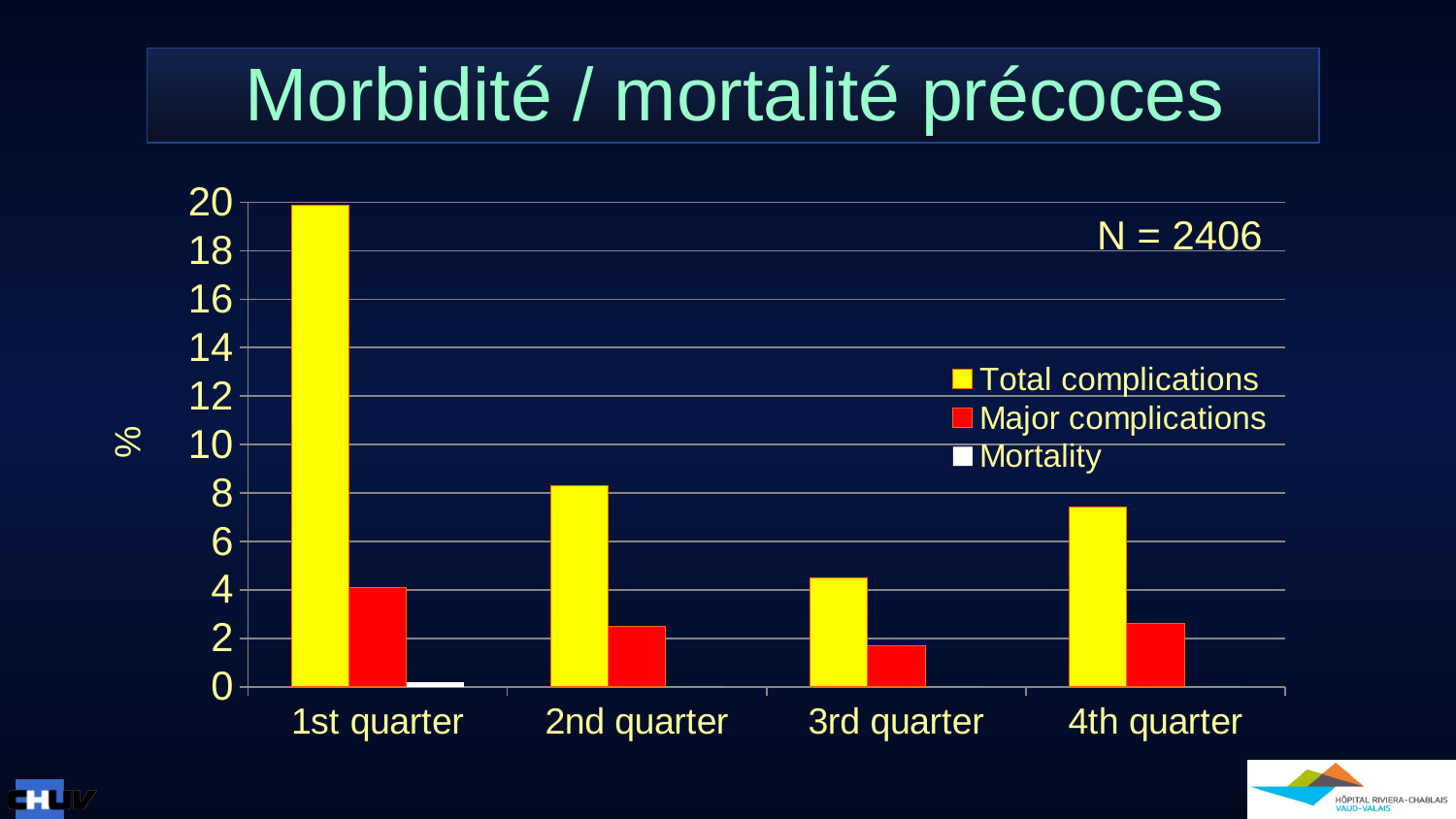
What sample size (N) is stated on the chart? N = 2406 Which quarter has the highest value for Major complications? 1st quarter How many series does the chart's legend list? 3 Is the Total complications value for the 3rd quarter greater or less than 6? less Which quarter has the highest value for Total complications? 1st quarter How many quarters are shown on the x axis of the chart? 4 What kind of chart is shown on the slide? bar chart Is the Total complications value for the 1st quarter greater or less than 18? greater Which quarter has the lowest value for Major complications? 3rd quarter Is the Major complications value for the 4th quarter greater or less than 4? less What is the title of the slide containing the chart? Morbidité / mortalité précoces Which quarter has the lowest value for Total complications? 3rd quarter